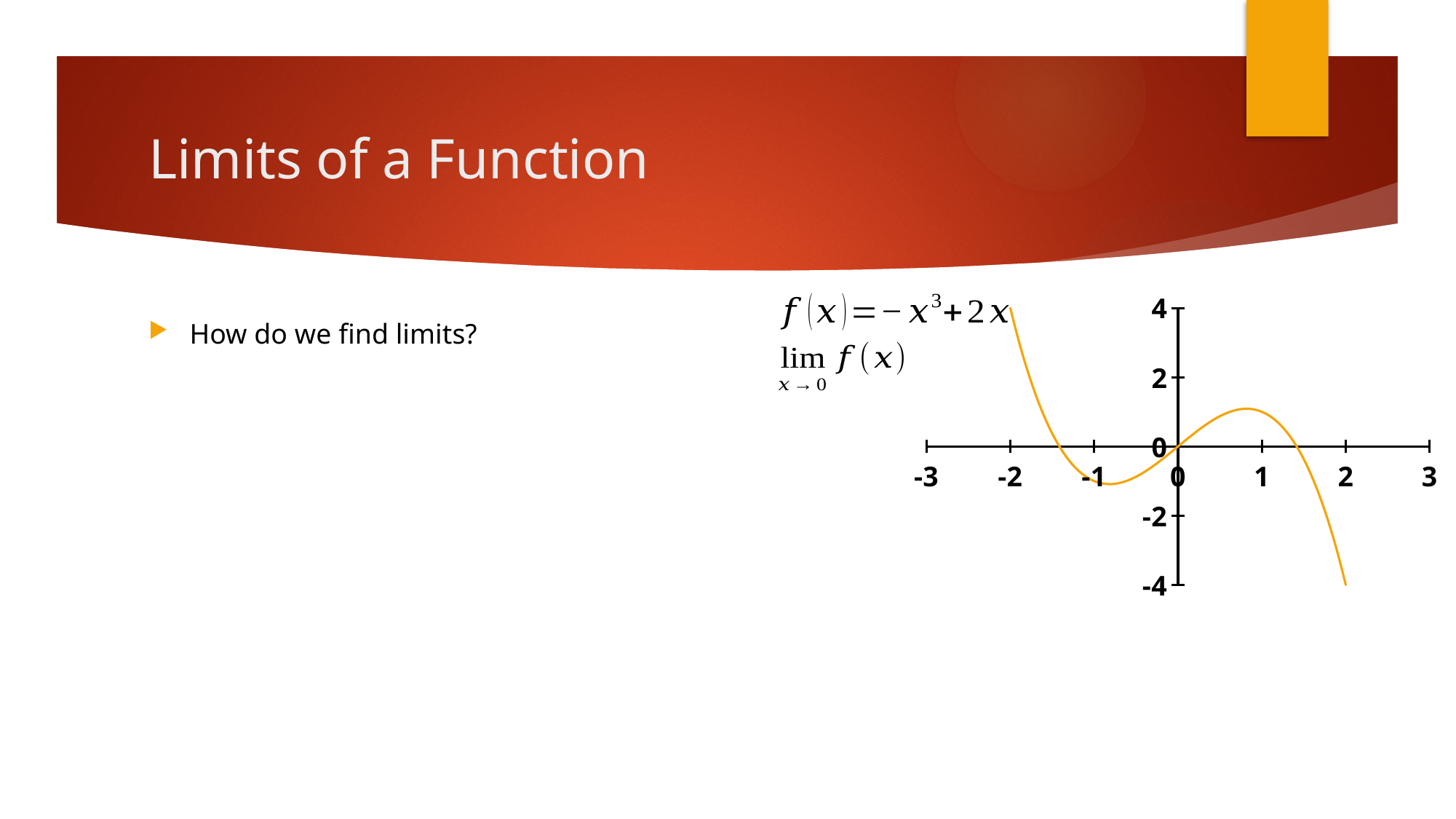
How many tick labels are shown on the x axis? 7 What is the value of the curve at x = -2, where it starts on the left? 4 What is the value of the curve at x = 2, where it ends on the right? -4 Is the value of the curve at x = 1 greater or less than 2? less Is the value of the curve at x = 1 greater or less than 0? greater What kind of chart is shown on the slide? line chart What function is plotted on the chart, according to the formula next to it? f(x) = -x^3 + 2x What is the value of the curve at x = 0? 0 Does the curve rise or fall as x goes from 1 to 2? fall Is the value of the curve at x = -1 greater or less than 0? less Does the curve rise or fall as x goes from -2 to -1? fall Which is larger, the value of the curve at x = -2 or at x = 2? x = -2